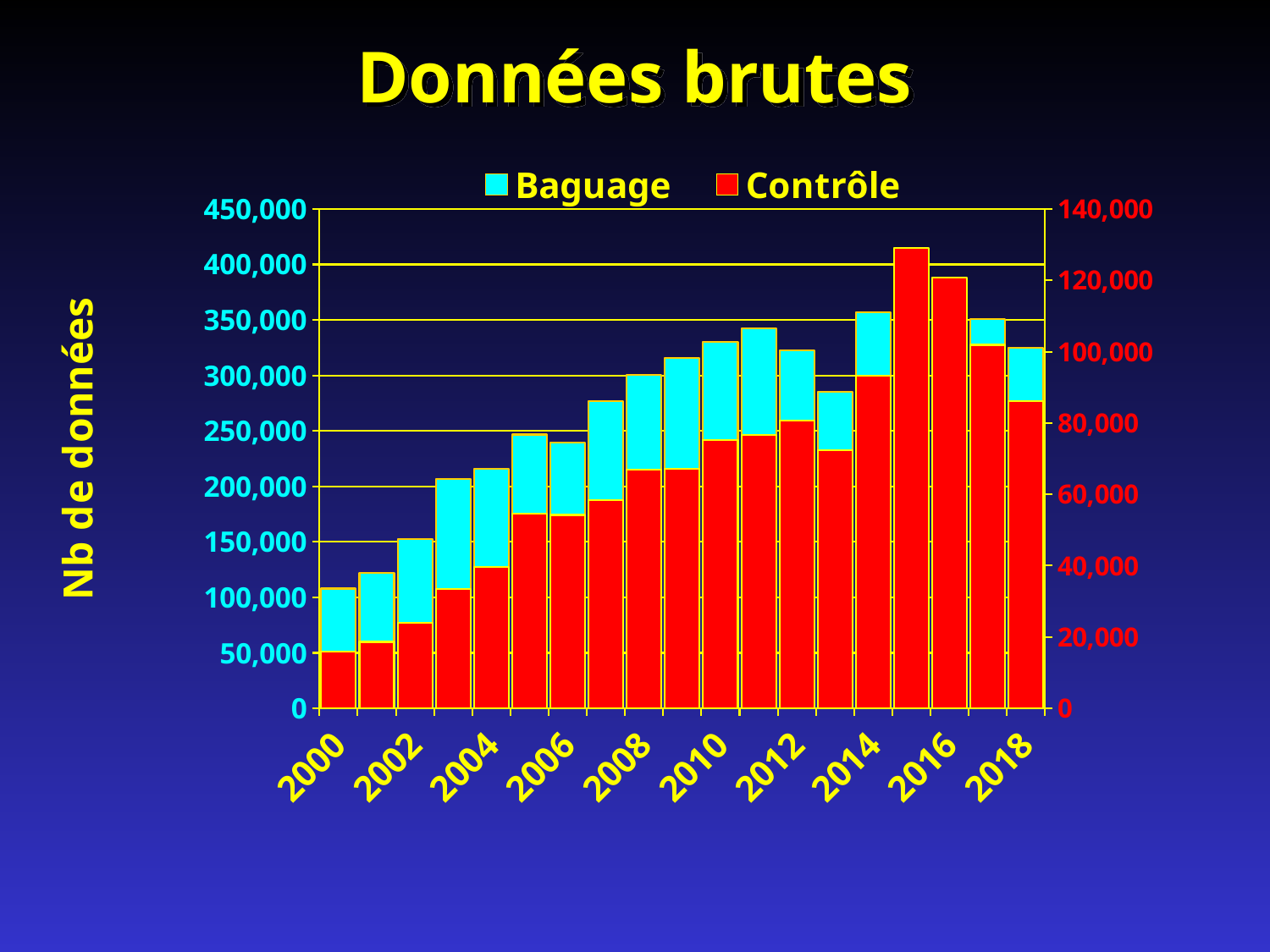
Read on the left axis, is the top of the bar for 2003 greater or less than 250,000? less What kind of chart is shown on the slide? bar chart Read on the left axis, is the top of the bar for 2000 greater or less than 50,000? greater How many series does the legend list? 2 What are the two series named in the legend? Baguage and Contrôle What is the label on the left vertical axis? Nb de données Read on the left axis, is the top of the bar for 2015 greater or less than 400,000? greater Which year has the tallest bar in the chart? 2015 Do the bar heights generally rise or fall from 2000 to 2015? rise How many years are plotted along the x axis? 19 What is the title of the slide? Données brutes Which year has the shortest bar in the chart? 2000